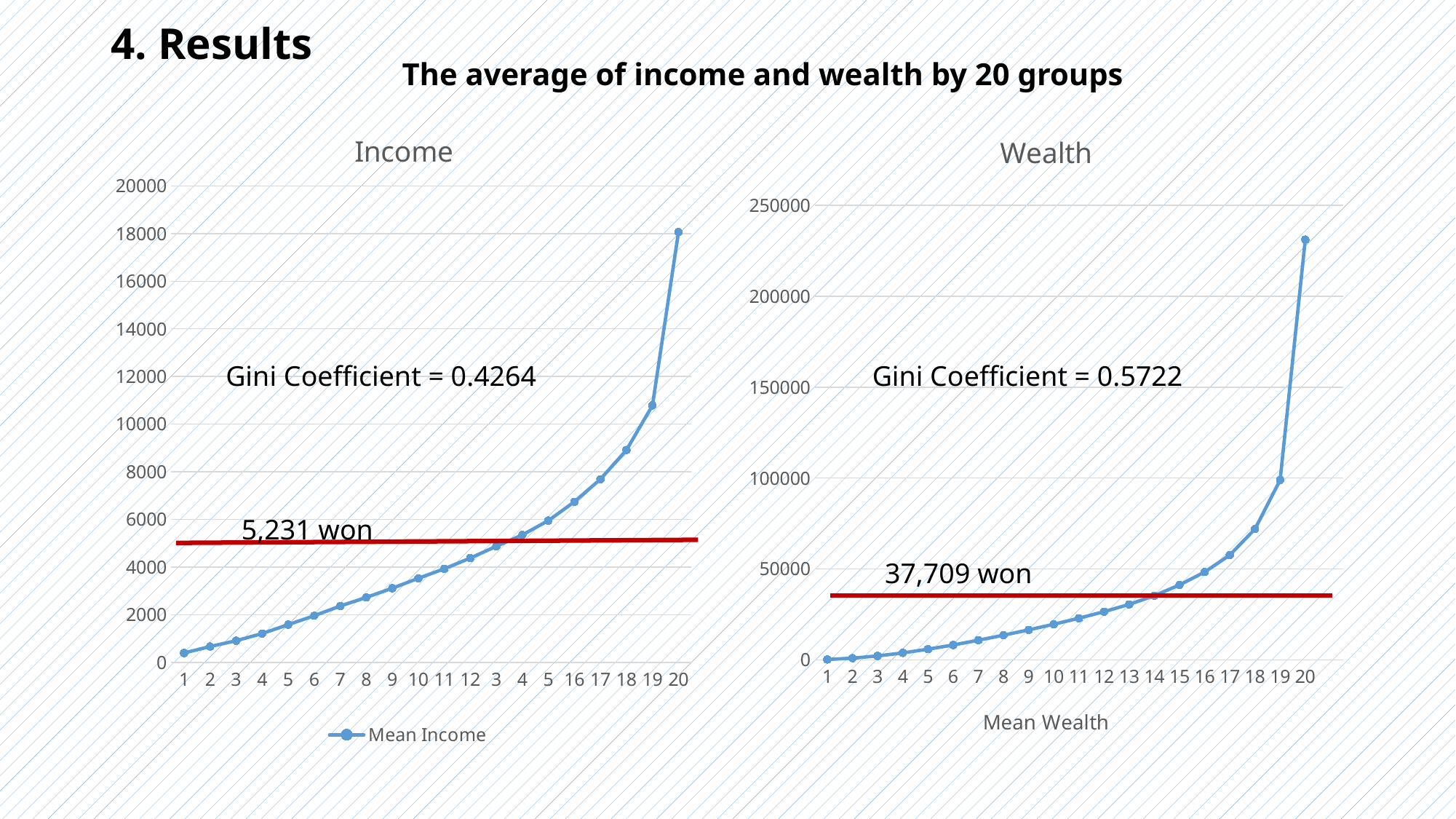
In the Wealth chart, which group has the highest mean wealth? 20 In the Income chart, which is larger, the value for group 19 or the value for group 20? group 20 In the Wealth chart, which is larger, the value for group 10 or the value for group 15? group 15 What value is labelled on the red horizontal line in the Wealth chart? 37,709 won How many groups are plotted along the x axis of the Wealth chart? 20 In the Income chart, which group has the lowest mean income? 1 What kind of chart is the Income chart? line chart In the Wealth chart, is the value for group 18 greater or less than 50000? greater In the Wealth chart, is the value for group 20 greater or less than 200000? greater In the Income chart, is the value for group 20 greater or less than 16000? greater What Gini coefficient is shown on the Income chart? 0.4264 In the Income chart, do the values rise or fall from group 1 to group 20? rise